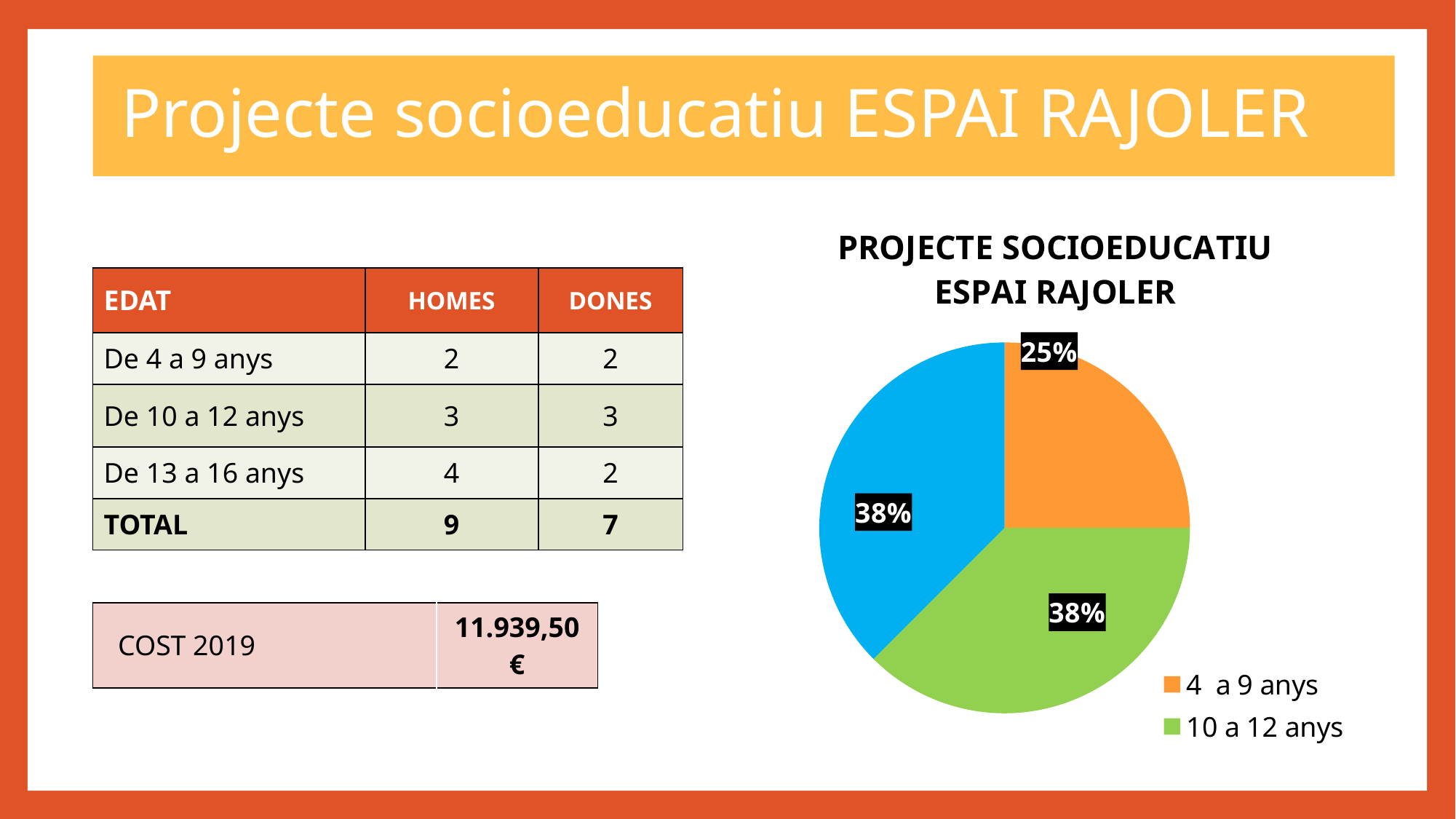
What percentage does the '4 a 9 anys' slice show in the pie chart? 25% What share of the pie does the '4 a 9 anys' slice represent? 25% What colour is the '4 a 9 anys' slice in the pie chart? orange What percentage does the '10 a 12 anys' slice show in the pie chart? 38% What is the title of the pie chart? PROJECTE SOCIOEDUCATIU ESPAI RAJOLER Which slice is larger in the pie chart, '4 a 9 anys' or '10 a 12 anys'? 10 a 12 anys What kind of chart is shown on the slide? pie chart Which legend category has the smallest slice in the pie chart? 4 a 9 anys How many entries does the pie chart's legend list? 2 How many slices does the pie chart have? 3 By how many percentage points is the '10 a 12 anys' slice larger than the '4 a 9 anys' slice? 13